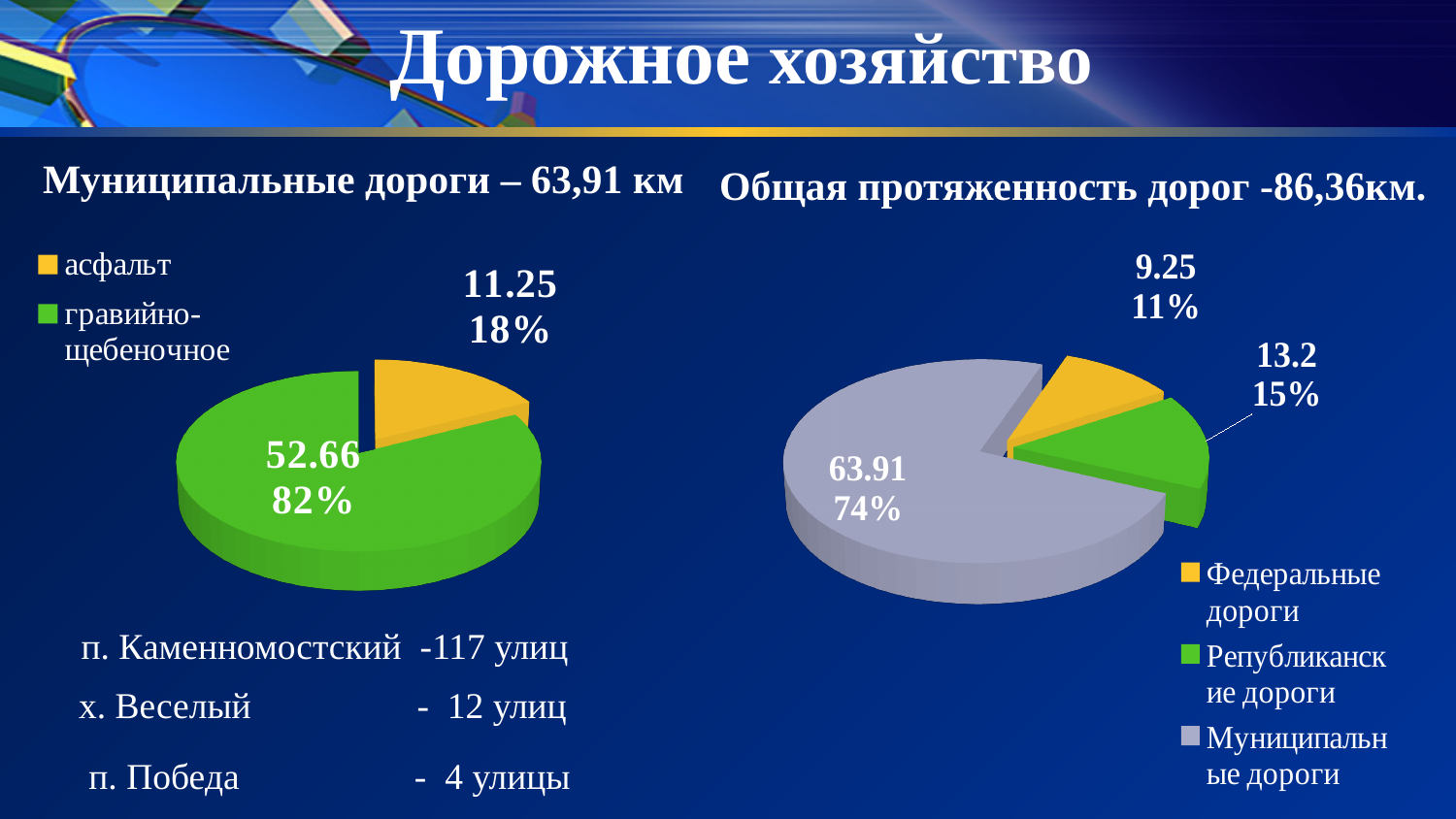
In the right pie chart (Общая протяженность дорог), which category is the smallest? Федеральные дороги In the left pie chart (Муниципальные дороги), what share does гравийно-щебеночное have? 82% In the right pie chart (Общая протяженность дорог), what share do Федеральные дороги have? 11% In the left pie chart (Муниципальные дороги), which category is the largest? гравийно-щебеночное In the left pie chart (Муниципальные дороги), what value is shown for асфальт? 11.25 How many entries does the legend of the right pie chart (Общая протяженность дорог) list? 3 In the right pie chart (Общая протяженность дорог), which is larger: Республиканские дороги or Федеральные дороги? Республиканские дороги In the right pie chart (Общая протяженность дорог), what is the difference between the values for Муниципальные дороги and Республиканские дороги? 50.71 In the left pie chart (Муниципальные дороги), what is the difference between the values for гравийно-щебеночное and асфальт? 41.41 What type of chart is used on the right side of the slide (Общая протяженность дорог)? pie chart How many categories does the left pie chart (Муниципальные дороги) show? 2 In the right pie chart (Общая протяженность дорог), what value is shown for Республиканские дороги? 13.2